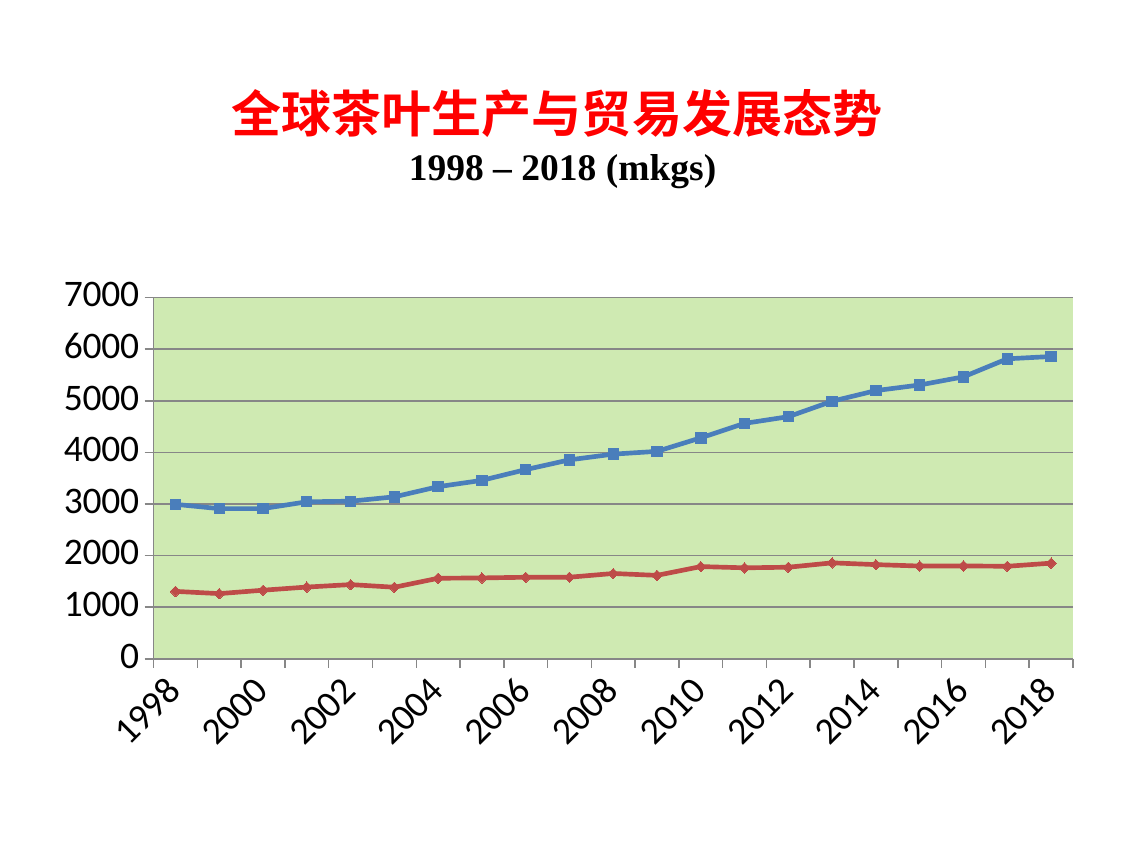
What unit is given in the chart's subtitle? mkgs Does the blue line rise or fall from 1998 to 2018? rise How many yearly data points does each line have, from 1998 to 2018? 21 Is the value of the blue line in 2010 greater or less than 4000? greater Is the value of the blue line in 1998 greater or less than 4000? less Is the value of the red line in 1998 greater or less than 1000? greater How many lines are plotted on the chart? 2 What kind of chart is shown on the slide? line chart In 2018, which line has the higher value, the blue line or the red line? the blue line